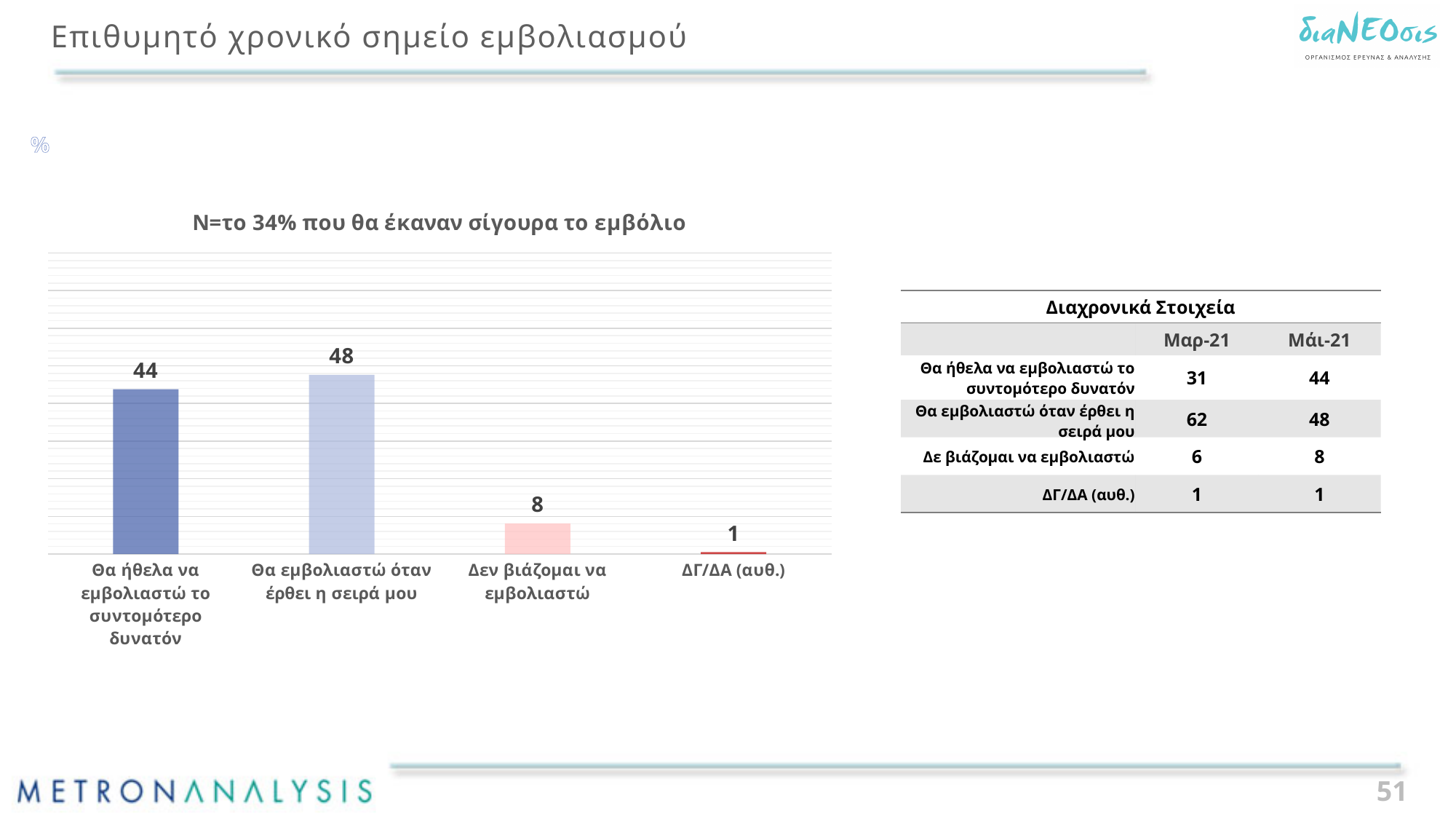
How many categories does the bar chart show? 4 What is the title shown above the bar chart? N=το 34% που θα έκαναν σίγουρα το εμβόλιο Which category has the lowest value in the bar chart? ΔΓ/ΔΑ (αυθ.) What is the value for "ΔΓ/ΔΑ (αυθ.)" in the bar chart? 1 What is the value for "Θα ήθελα να εμβολιαστώ το συντομότερο δυνατόν" in the bar chart? 44 What kind of chart is shown on the slide? bar chart What is the difference between the values for "Δεν βιάζομαι να εμβολιαστώ" and "ΔΓ/ΔΑ (αυθ.)" in the bar chart? 7 What is the value for "Θα εμβολιαστώ όταν έρθει η σειρά μου" in the bar chart? 48 What is the value for "Δεν βιάζομαι να εμβολιαστώ" in the bar chart? 8 Which is larger in the bar chart: the value for "Θα ήθελα να εμβολιαστώ το συντομότερο δυνατόν" or for "Δεν βιάζομαι να εμβολιαστώ"? Θα ήθελα να εμβολιαστώ το συντομότερο δυνατόν What is the difference between the values for "Θα εμβολιαστώ όταν έρθει η σειρά μου" and "Θα ήθελα να εμβολιαστώ το συντομότερο δυνατόν"? 4 Which category has the highest value in the bar chart? Θα εμβολιαστώ όταν έρθει η σειρά μου